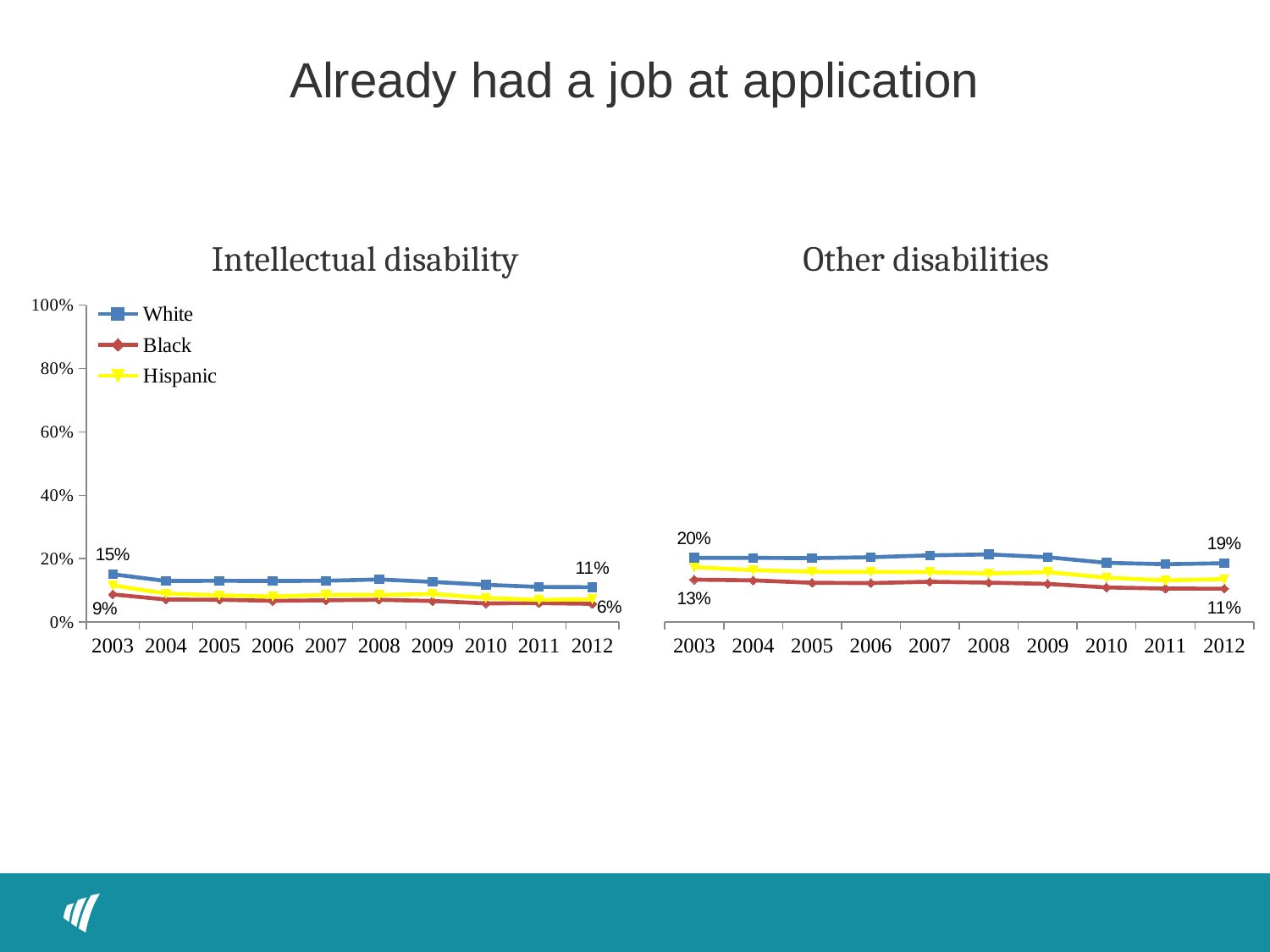
In the Intellectual disability chart, what is the difference between the White value in 2003 and the White value in 2012? 4 percentage points In the Other disabilities chart, what is the difference between the White value in 2012 and the Black value in 2012? 8 percentage points Which is larger: the White value in 2003 in the Intellectual disability chart or the White value in 2003 in the Other disabilities chart? Other disabilities In the Intellectual disability chart, is the value for White in 2008 greater or less than 20%? less In the Other disabilities chart, what is the value for White in 2012? 19% How many years are shown on the x axis of the Other disabilities chart? 10 What kind of chart is the Intellectual disability chart? Line chart In the Intellectual disability chart, what is the value for White in 2003? 15% How many series does the legend of the Intellectual disability chart list? 3 In the Other disabilities chart, what is the value for Black in 2003? 13% In the Intellectual disability chart, does the White series rise or fall from 2003 to 2012? Fall In the Intellectual disability chart, what is the value for Black in 2012? 6%